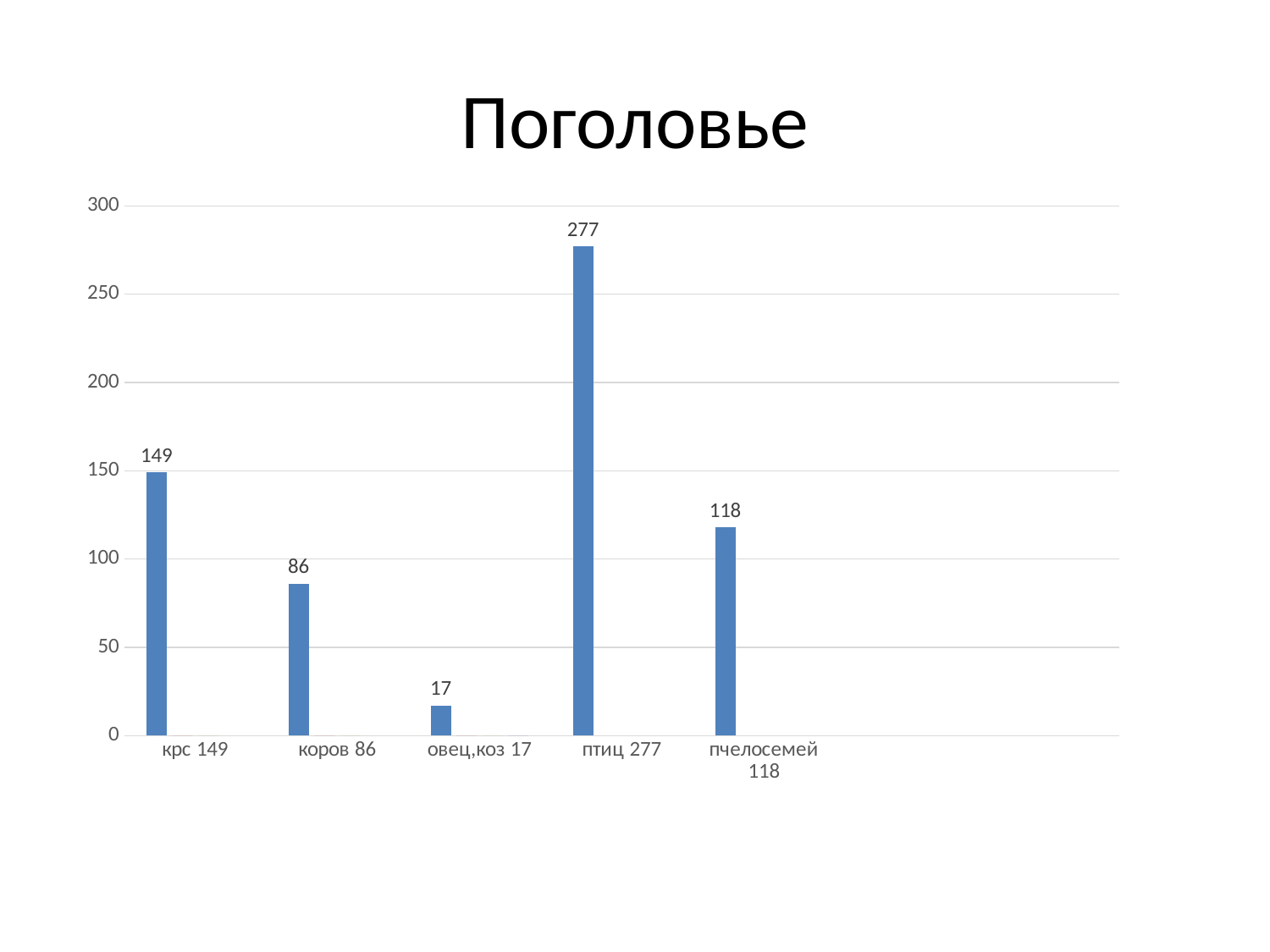
What is the value for овец,коз 17? 17 Which category has the lowest value? овец,коз 17 How many categories are shown in the chart? 5 Is the value for птиц 277 greater or less than 250? greater What is the value for пчелосемей 118? 118 What is the value for крс 149? 149 Which category has the highest value? птиц 277 What is the title of the slide? Поголовье What is the value for коров 86? 86 Which is larger, the value for коров 86 or the value for пчелосемей 118? пчелосемей 118 What kind of chart is shown on the slide? bar chart What is the difference between the values for птиц 277 and крс 149? 128